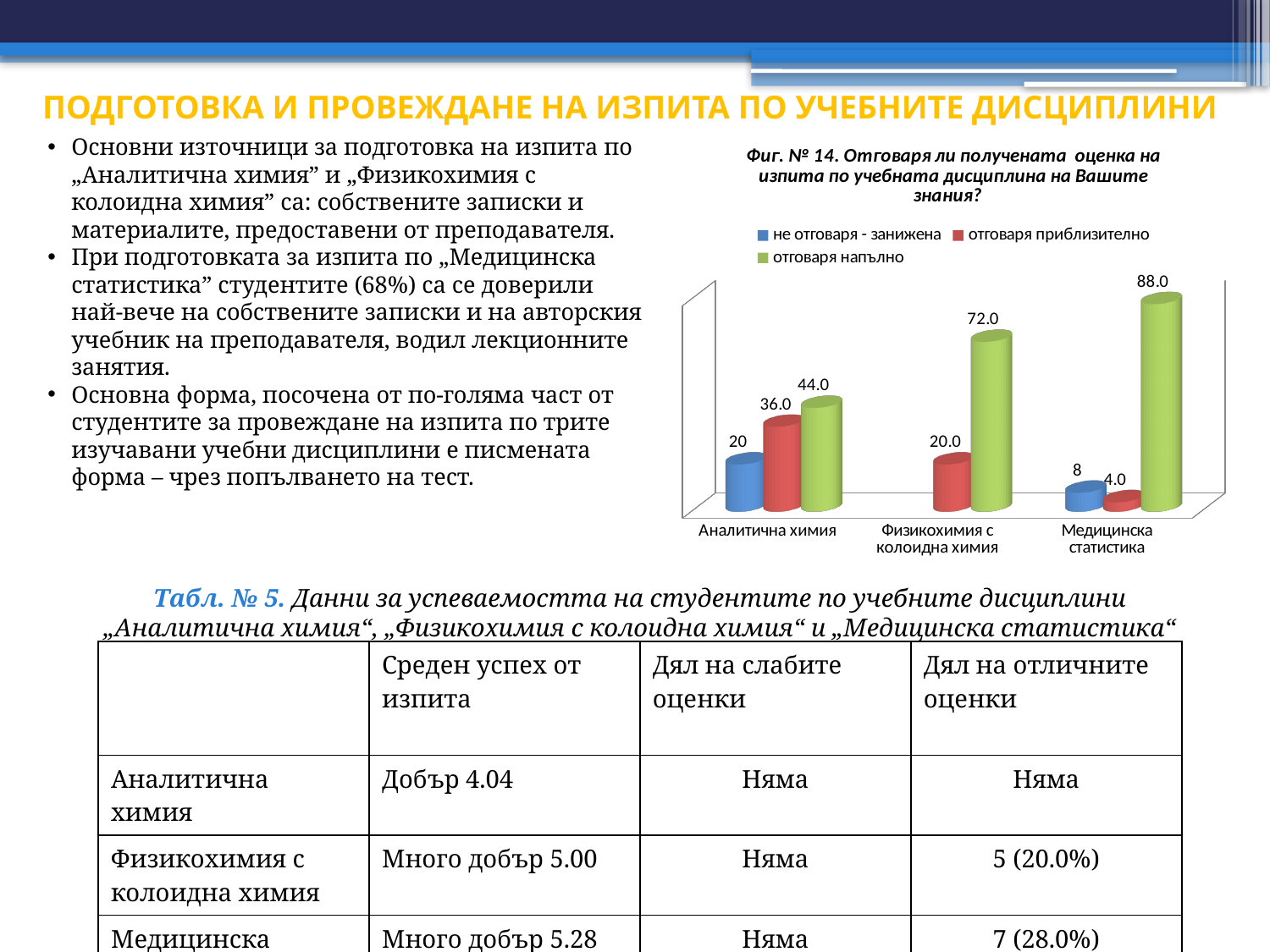
Which is larger: "отговаря приблизително" for Аналитична химия or for Физикохимия с колоидна химия? Аналитична химия What is the value of "не отговаря - занижена" for Медицинска статистика? 8 What is the value of "отговаря приблизително" for Аналитична химия? 36.0 How many series does the chart legend list? 3 What is the value of "отговаря напълно" for Медицинска статистика? 88.0 What is the difference between the "отговаря напълно" values for Медицинска статистика and Аналитична химия? 44.0 What kind of chart is shown on the slide? bar chart Which category has the highest value for "отговаря напълно"? Медицинска статистика What is the value of "отговаря напълно" for Физикохимия с колоидна химия? 72.0 How many categories are shown on the x axis of the chart? 3 Which series is shown in green in the chart? отговаря напълно Which category has the lowest value for "отговаря приблизително"? Медицинска статистика